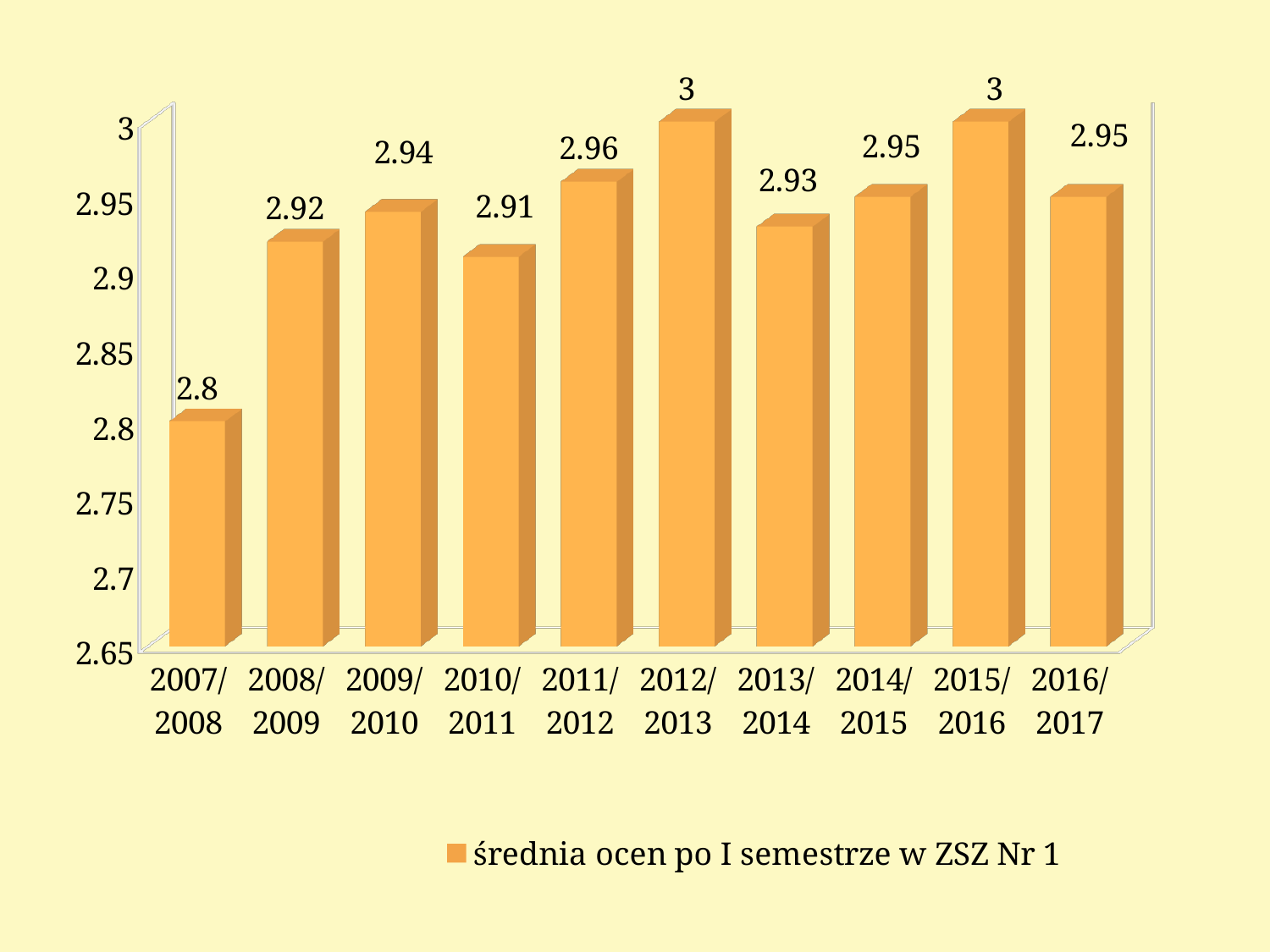
How many categories are shown on the x axis? 10 What is the difference between the values for 2012/2013 and 2007/2008? 0.2 Which category has the lowest value? 2007/2008 What kind of chart is this? bar chart What is the value for 2011/2012? 2.96 Which is larger, the value for 2009/2010 or the value for 2010/2011? 2009/2010 Is the value for 2007/2008 greater or less than 2.85? less What is the legend entry for the series? średnia ocen po I semestrze w ZSZ Nr 1 What is the value for 2013/2014? 2.93 What is the value for 2007/2008? 2.8 What is the value for 2016/2017? 2.95 What is the difference between the values for 2011/2012 and 2010/2011? 0.05